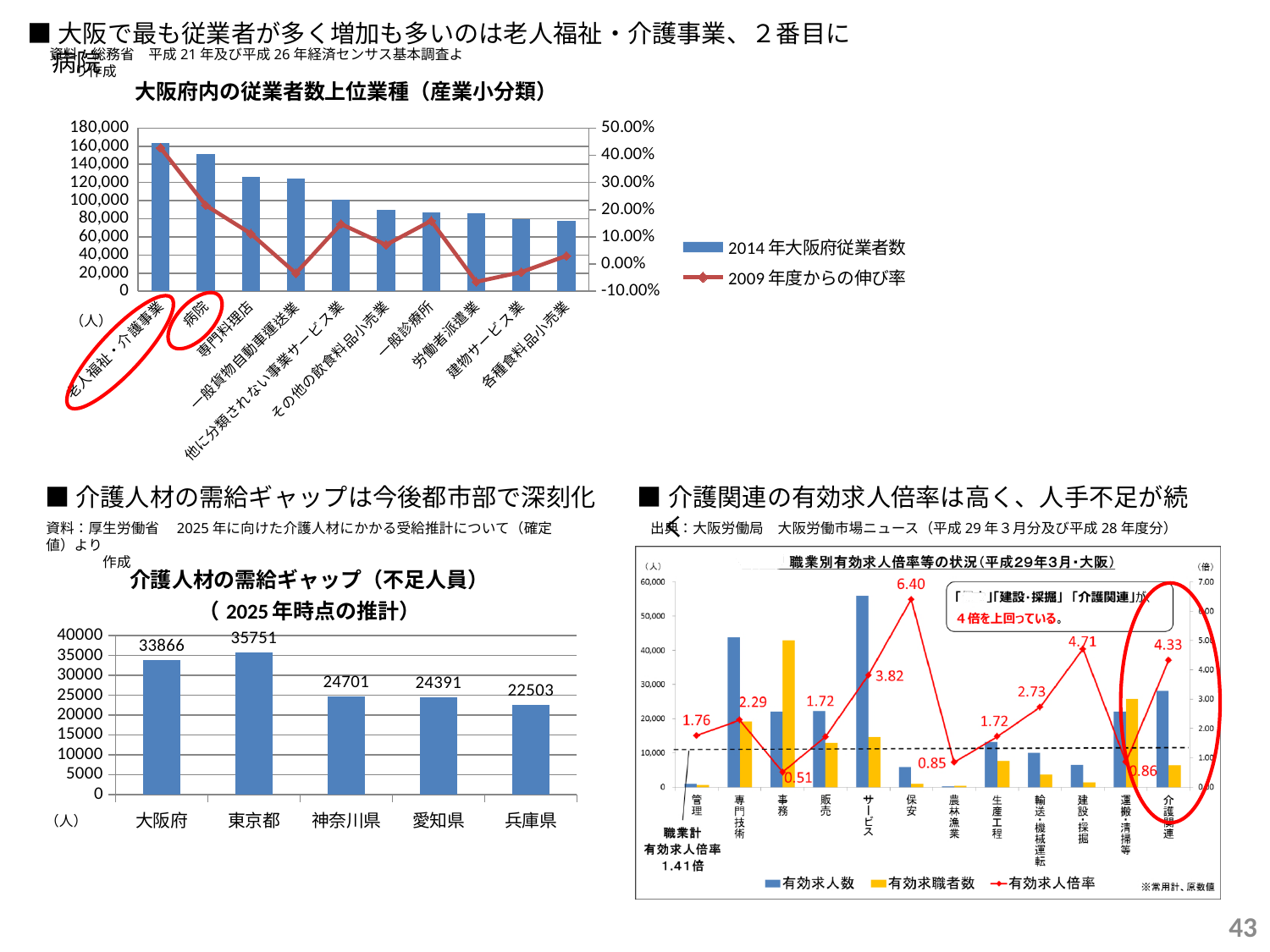
In the chart titled 介護人材の需給ギャップ（不足人員）, what is the value for 東京都? 35751 In the chart titled 大阪府内の従業者数上位業種（産業小分類）, do the 2014年大阪府従業者数 bars rise or fall from left to right? fall In the chart titled 職業別有効求人倍率等の状況（平成29年3月・大阪）, which is larger, the 有効求人倍率 for 建設・採掘 or for 輸送・機械運転? 建設・採掘 In the chart titled 介護人材の需給ギャップ（不足人員）, what is the difference between 大阪府 and 神奈川県? 9165 In the chart titled 大阪府内の従業者数上位業種（産業小分類）, is the 2014年大阪府従業者数 bar for 病院 greater or less than 140,000? greater In the chart titled 介護人材の需給ギャップ（不足人員）, what is the value for 兵庫県? 22503 In the chart titled 職業別有効求人倍率等の状況（平成29年3月・大阪）, what is the 有効求人倍率 for 介護関連? 4.33 In the chart titled 職業別有効求人倍率等の状況（平成29年3月・大阪）, which occupation has the highest 有効求人倍率? 保安 In the chart titled 大阪府内の従業者数上位業種（産業小分類）, how many series does the legend list? 2 In the chart titled 大阪府内の従業者数上位業種（産業小分類）, how many industry categories are shown on the x axis? 10 In the chart titled 介護人材の需給ギャップ（不足人員）, how many prefectures are shown? 5 In the chart titled 介護人材の需給ギャップ（不足人員）, which prefecture has the highest value? 東京都